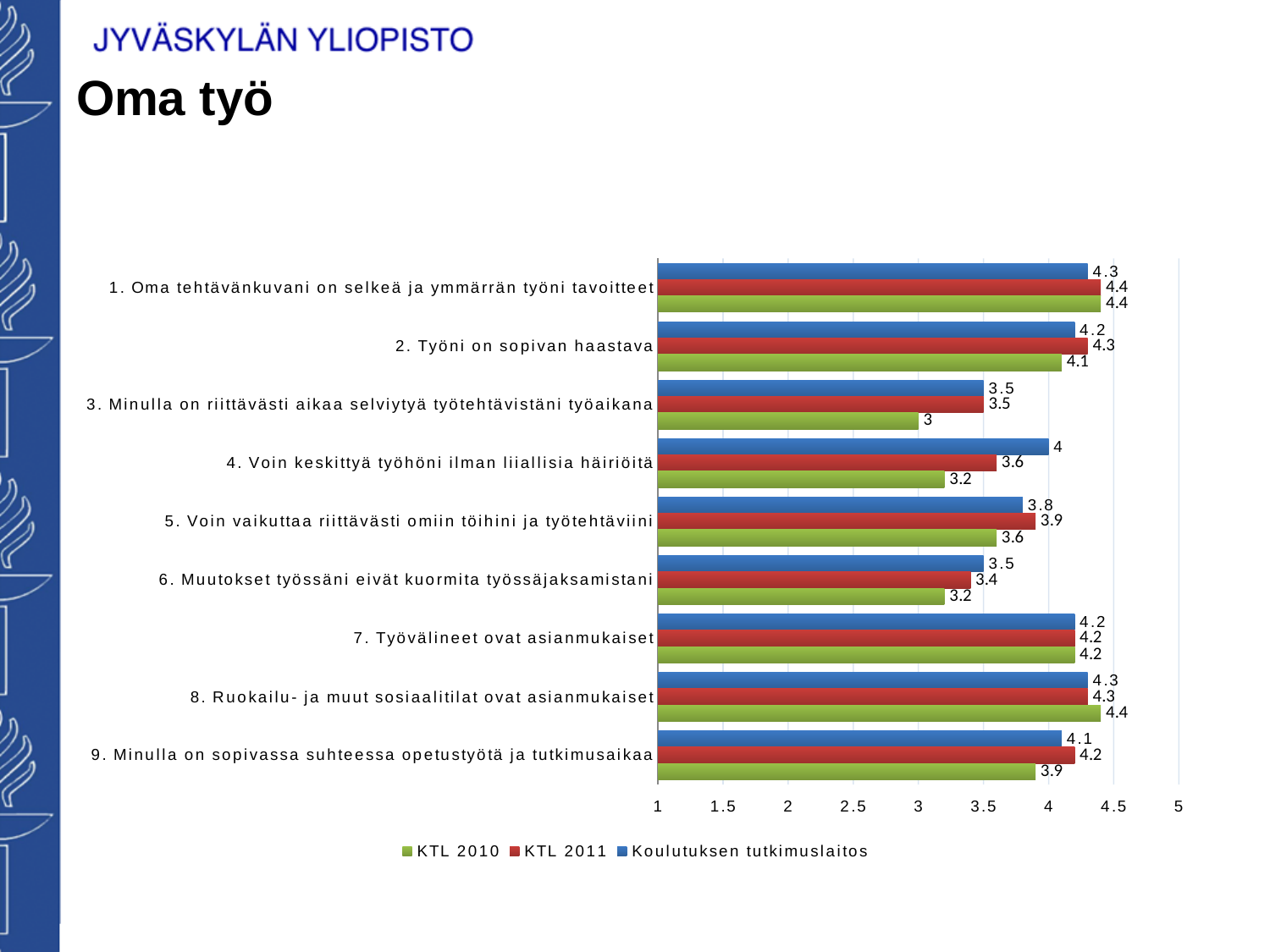
What is the KTL 2011 value for "9. Minulla on sopivassa suhteessa opetustyötä ja tutkimusaikaa"? 4.2 Which colour represents the KTL 2011 series in the chart? red What is the KTL 2010 value for "3. Minulla on riittävästi aikaa selviytyä työtehtävistäni työaikana"? 3 Is the KTL 2010 value for "6. Muutokset työssäni eivät kuormita työssäjaksamistani" greater or less than 3.5? less What is the difference between the Koulutuksen tutkimuslaitos value and the KTL 2010 value for "4. Voin keskittyä työhöni ilman liiallisia häiriöitä"? 0.8 Which statement has the lowest KTL 2010 value? 3. Minulla on riittävästi aikaa selviytyä työtehtävistäni työaikana How many series does the legend list? 3 What type of chart is shown on the slide? bar chart How many categories (statements) are plotted on the chart? 9 What is the Koulutuksen tutkimuslaitos value for "4. Voin keskittyä työhöni ilman liiallisia häiriöitä"? 4 For "5. Voin vaikuttaa riittävästi omiin töihini ja työtehtäviini", which is larger: the KTL 2011 value or the KTL 2010 value? KTL 2011 Which statement has the highest KTL 2011 value? 1. Oma tehtävänkuvani on selkeä ja ymmärrän työni tavoitteet